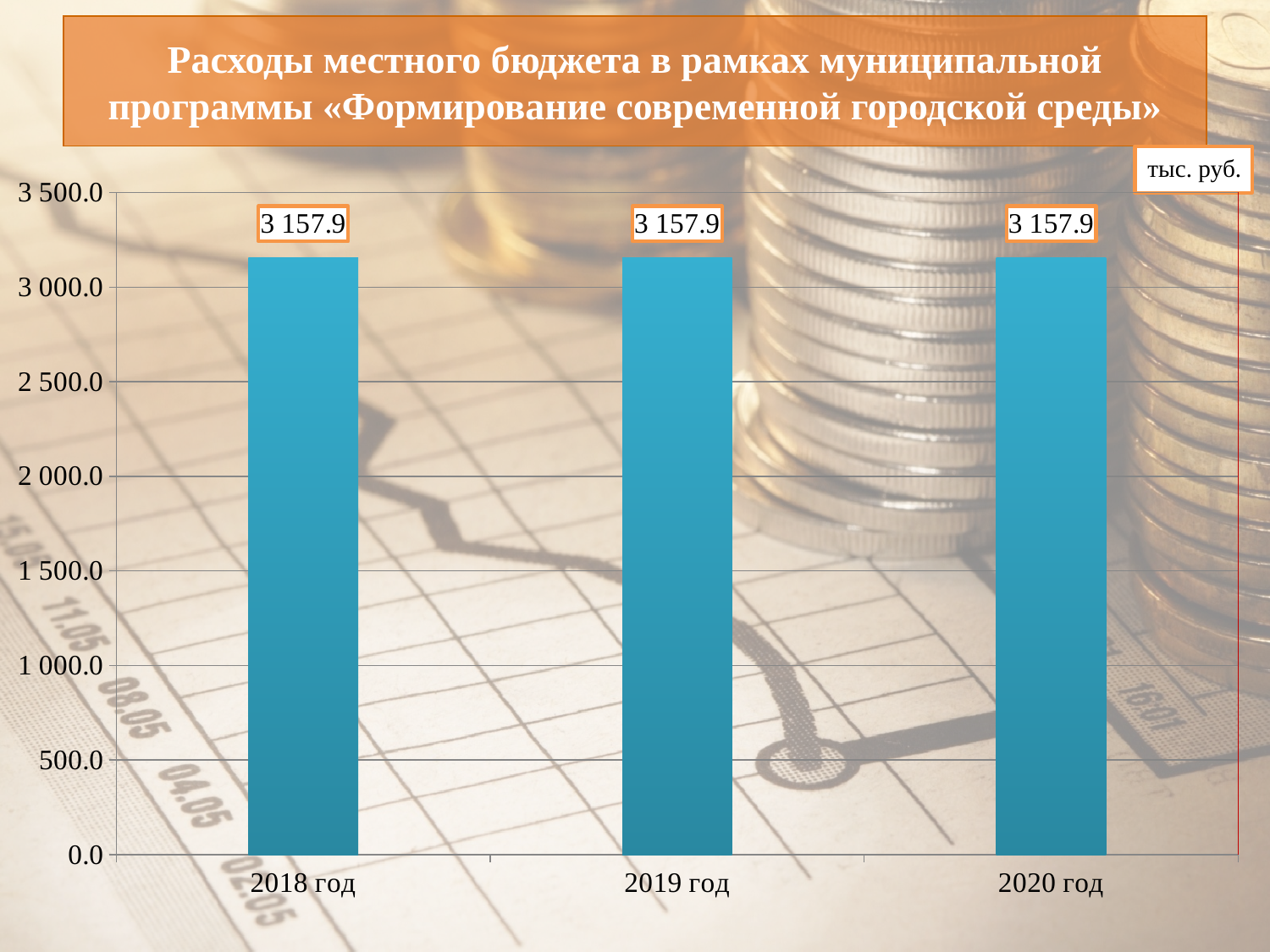
What is the value for 2019 год? 3 157.9 In what units are the values on the chart expressed? тыс. руб. How many categories (years) are shown on the x axis? 3 What is the difference between the values for 2020 год and 2018 год? 0.0 What is the value for 2020 год? 3 157.9 What is the value for 2018 год? 3 157.9 What kind of chart is shown on the slide? Bar chart Is the value for 2020 год greater or less than 3 500.0? less What is the title of the chart? Расходы местного бюджета в рамках муниципальной программы «Формирование современной городской среды» Do the values rise, fall or stay the same from 2018 год to 2020 год? Stay the same Is the value for 2019 год greater or less than 3 000.0? greater